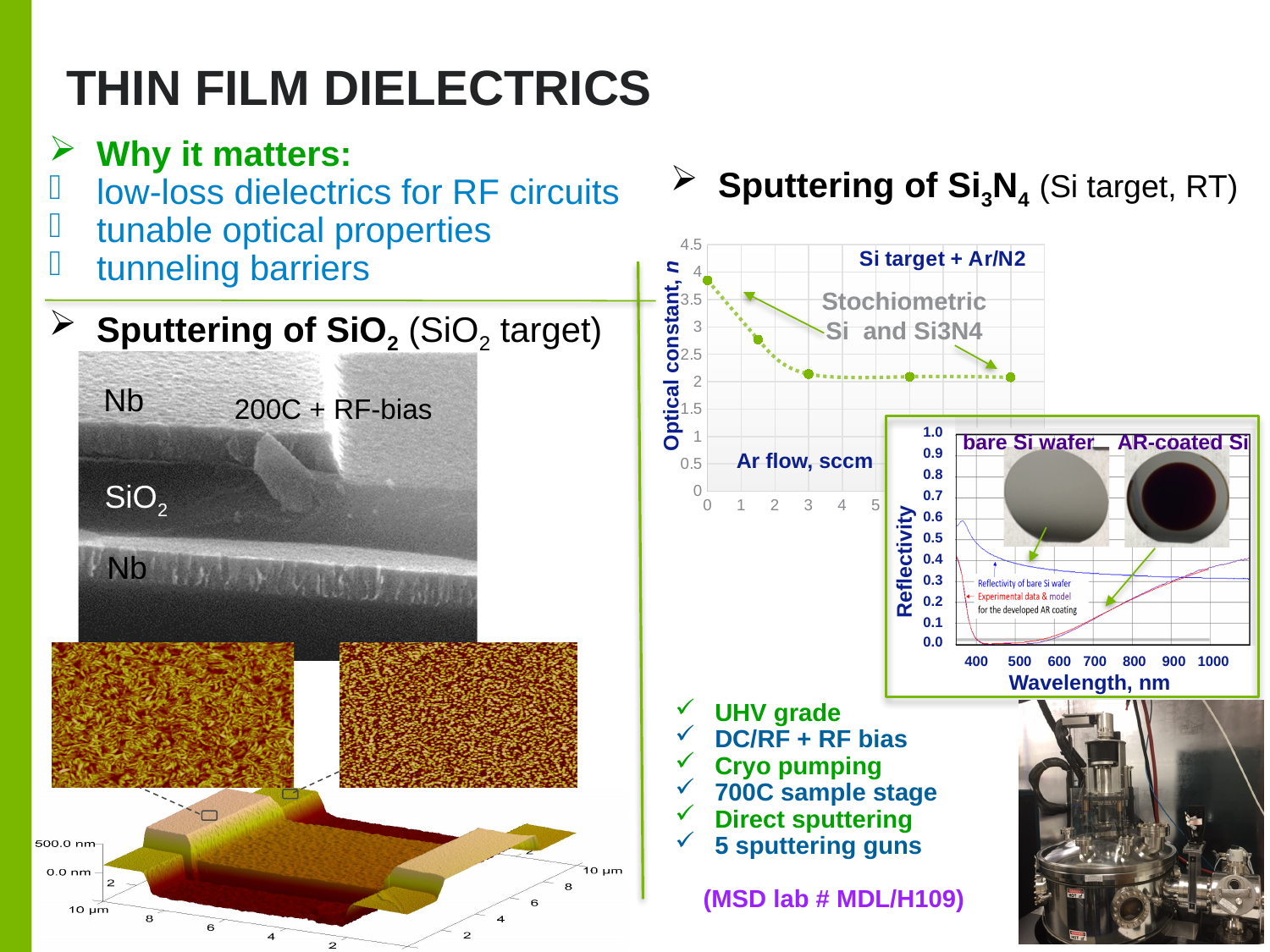
In the reflectivity chart, what is the label of the x axis? Wavelength, nm In the 'Si target + Ar/N2' chart, does the optical constant rise or fall as Ar flow increases? fall In the 'Si target + Ar/N2' chart, is the optical constant at an Ar flow of 0 sccm greater or less than 3.5? greater In the reflectivity chart, is the reflectivity of the bare Si wafer at 500 nm greater or less than 0.3? greater In the reflectivity chart, what kind of chart is it? line chart In the 'Si target + Ar/N2' chart, which Ar flow value gives the highest optical constant? 0 sccm In the reflectivity chart, at 500 nm, which has the higher reflectivity: the bare Si wafer or the AR-coated Si? bare Si wafer In the 'Si target + Ar/N2' chart, how many data points are plotted? 5 In the 'Si target + Ar/N2' chart, what is the label of the x axis? Ar flow, sccm In the 'Si target + Ar/N2' chart, is the optical constant at an Ar flow of 3 sccm greater or less than 2.5? less In the 'Si target + Ar/N2' chart, what is the label of the y axis? Optical constant, n